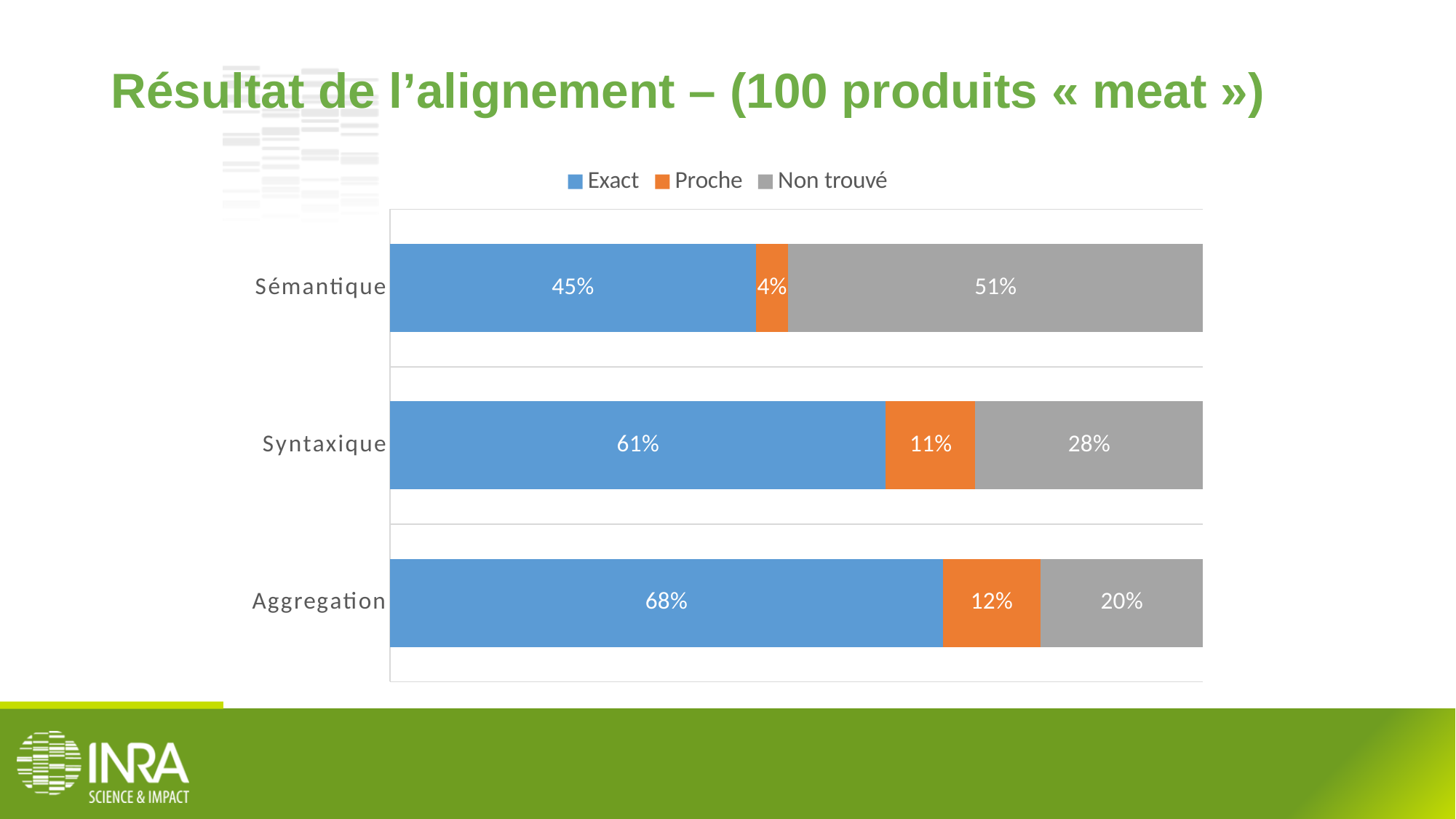
What is the total of the stacked bar for Syntaxique? 100% Which is larger, the Exact value for Syntaxique or the Exact value for Sémantique? Syntaxique Which category has the highest Exact value? Aggregation What kind of chart is shown? Stacked bar chart Which series is shown in orange? Proche What is the Proche value for Aggregation? 12% How many categories are shown on the chart? 3 What is the difference between the Non trouvé values for Sémantique and Aggregation? 31% What is the Exact value for Sémantique? 45% How many series does the legend list? 3 What is the Non trouvé value for Syntaxique? 28% Which category has the lowest Proche value? Sémantique